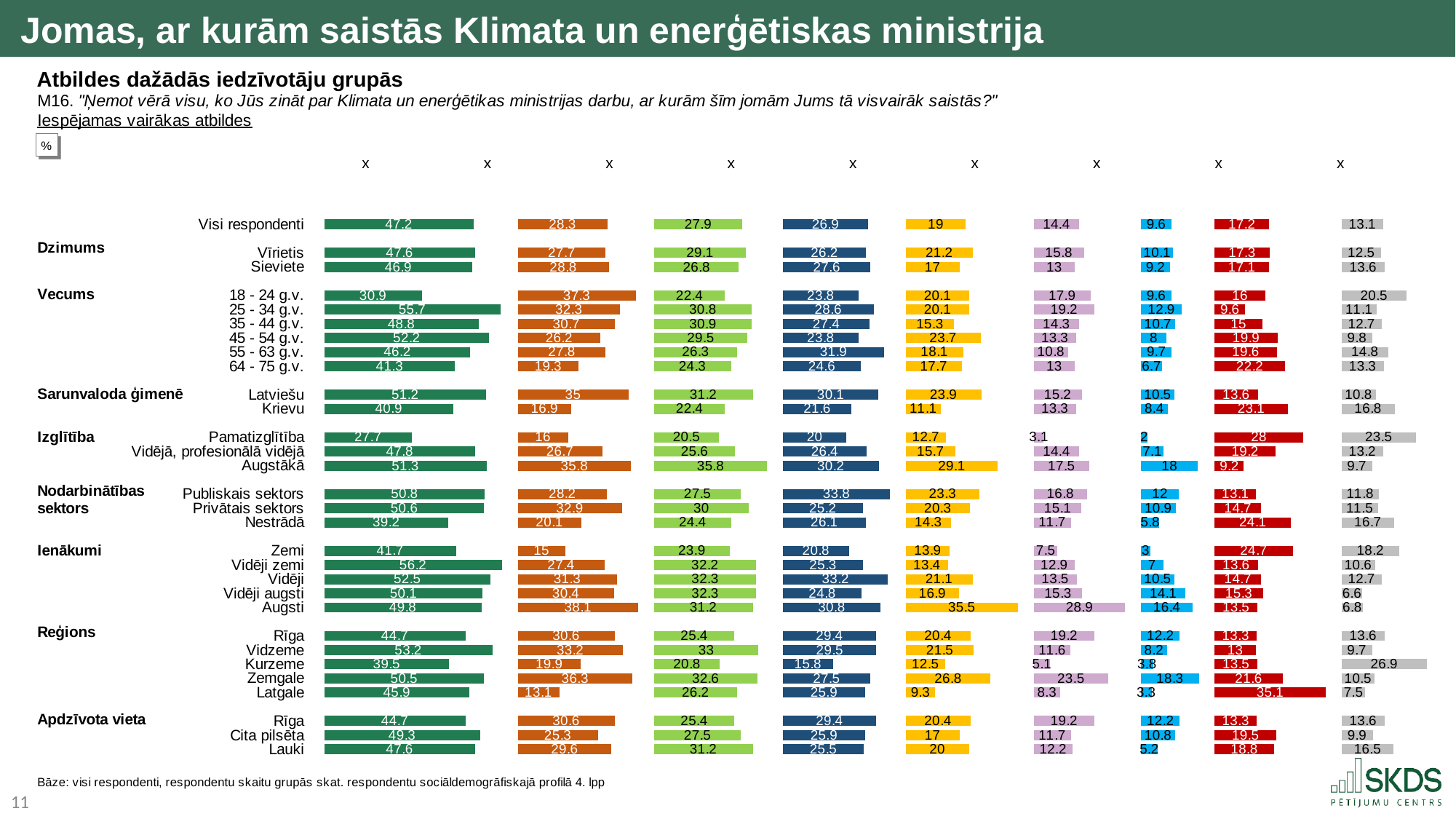
In the rightmost (grey) column of bars, what is the value for "Kurzeme"? 26.9 In the dark green column, which of the "Reģions" rows has the lowest value? Kurzeme In the leftmost (dark green) column of bars, what is the value for "Visi respondenti"? 47.2 In the red column of bars, which is larger: the value for "Latgale" or for "Rīga" under "Reģions"? Latgale In the dark green column, what is the difference between the values for "Latviešu" and "Krievu"? 10.3 In the orange column of bars, what is the value for the "18 - 24 g.v." age group? 37.3 What kind of chart is shown on the slide? bar chart In the dark green column, which of the "Vecums" age groups has the highest value? 25 - 34 g.v. In the yellow column of bars, what is the value for "Augsti"? 35.5 In the light blue column, what is the difference between the values for "Augstākā" and "Pamatizglītība"? 16 How many rows are listed under the "Ienākumi" group? 5 How many columns of bars (response categories) are shown across the slide? 9